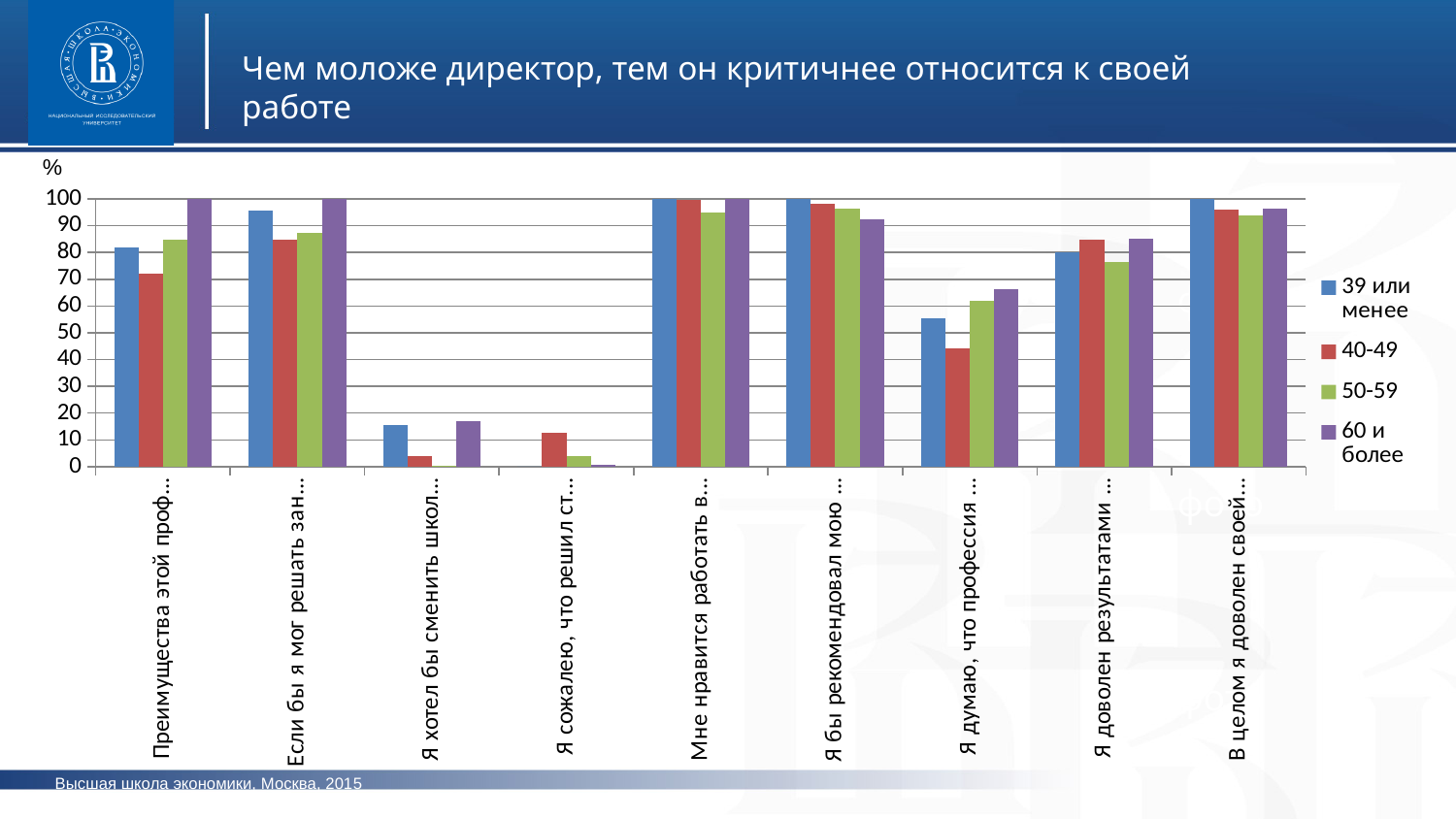
What is the value for the "60 и более" series in the category "Преимущества этой проф..."? 100 What kind of chart is shown on the slide? bar chart In the category "Преимущества этой проф...", which is larger: the value for "39 или менее" or for "40-49"? 39 или менее Is the value for the "39 или менее" series in the category "Я хотел бы сменить школ..." greater or less than 10? greater In the category "Я доволен результатами ...", which is larger: the value for "40-49" or for "50-59"? 40-49 Is the value for the "40-49" series in the category "Я думаю, что профессия ..." greater or less than 50? less Which series has the lowest value in the category "Я думаю, что профессия ..."? 40-49 How many categories are shown along the x axis? 9 How many series does the legend list? 4 Which series has the highest value in the category "Я думаю, что профессия ..."? 60 и более What is the value for the "39 или менее" series in the category "Я доволен результатами ..."? 80 What is the title of the slide? Чем моложе директор, тем он критичнее относится к своей работе